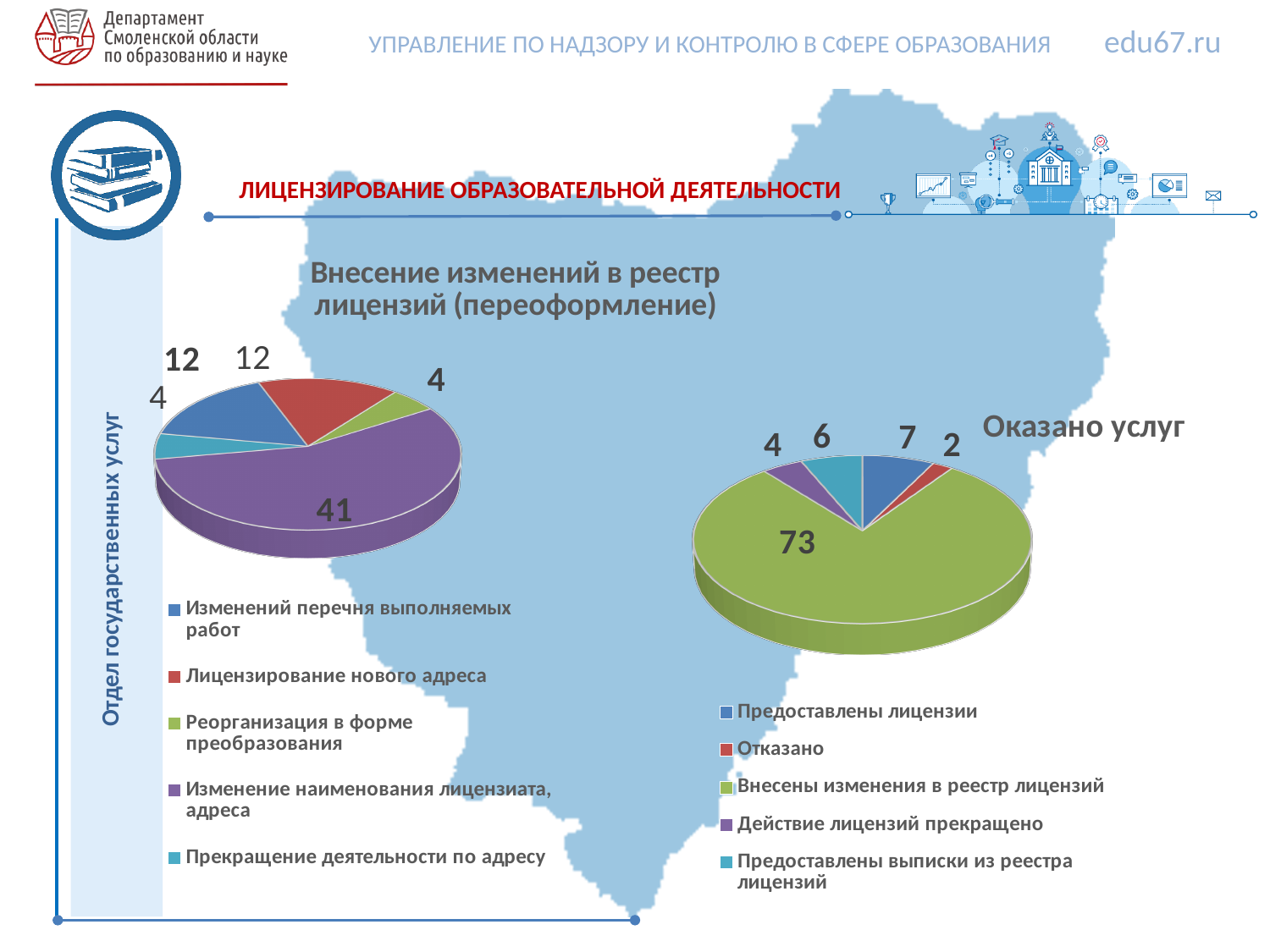
In the 'Оказано услуг' chart, what is the value for 'Внесены изменения в реестр лицензий'? 73 In the 'Оказано услуг' chart, what is the value for 'Отказано'? 2 In the 'Оказано услуг' chart, which is larger: 'Предоставлены лицензии' or 'Предоставлены выписки из реестра лицензий'? Предоставлены лицензии In the 'Внесение изменений в реестр лицензий (переоформление)' chart, what is the value for 'Лицензирование нового адреса'? 12 In the 'Внесение изменений в реестр лицензий (переоформление)' chart, which category has the largest value? Изменение наименования лицензиата, адреса In the 'Оказано услуг' chart, which category has the smallest value? Отказано In the 'Внесение изменений в реестр лицензий (переоформление)' chart, what is the value for 'Изменение наименования лицензиата, адреса'? 41 In the 'Оказано услуг' chart, what is the difference between 'Предоставлены лицензии' and 'Действие лицензий прекращено'? 3 In the 'Внесение изменений в реестр лицензий (переоформление)' chart, what is the difference between 'Изменение наименования лицензиата, адреса' and 'Изменений перечня выполняемых работ'? 29 In the 'Оказано услуг' chart, what colour is the slice for 'Внесены изменения в реестр лицензий'? green In the 'Внесение изменений в реестр лицензий (переоформление)' chart, how many categories does the legend list? 5 What kind of chart is the 'Внесение изменений в реестр лицензий (переоформление)' chart? pie chart